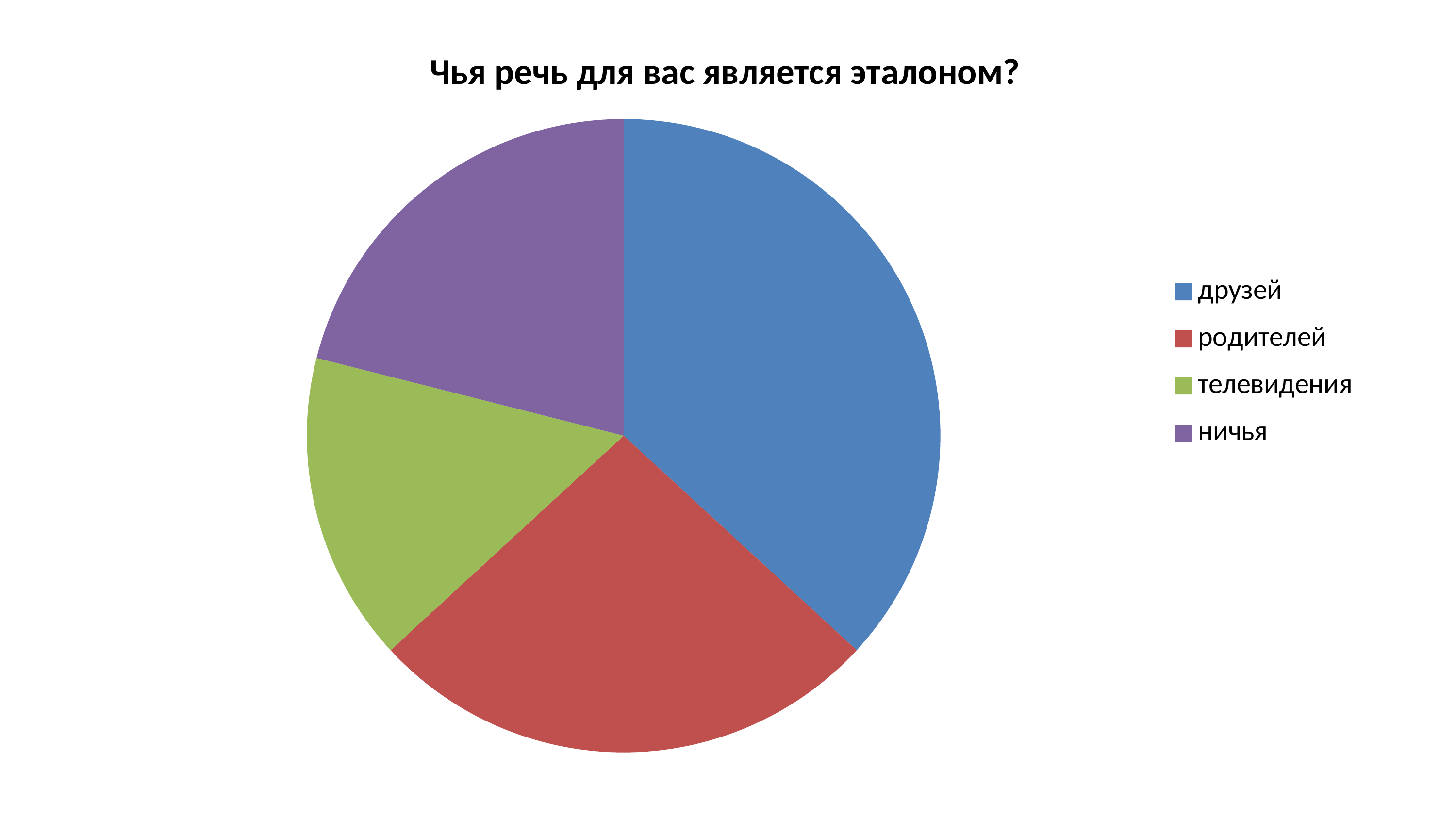
Which colour represents the category ничья in the pie chart? purple Which slice is larger, родителей or телевидения? родителей How many entries does the legend list? 4 How many slices does the pie chart have? 4 Which slice is larger, друзей or ничья? друзей What kind of chart is shown on the slide? pie chart Which category has the largest slice of the pie? друзей What is the title of the chart? Чья речь для вас является эталоном? Which slice is larger, друзей or родителей? друзей Which category has the smallest slice of the pie? телевидения